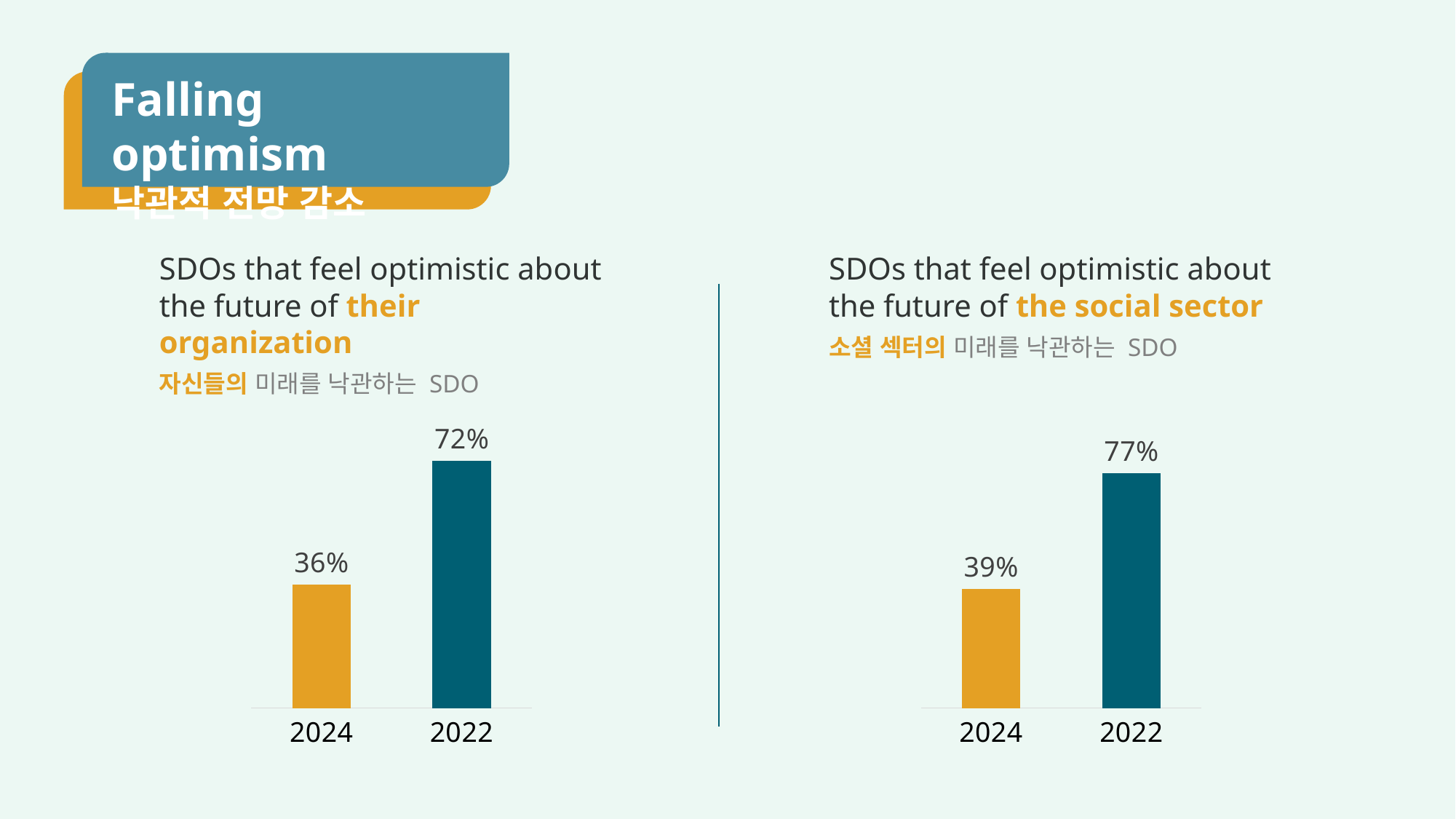
In the left chart (SDOs optimistic about the future of their organization), which year has the higher value? 2022 What colour is the 2024 bar in the left chart (SDOs optimistic about the future of their organization)? orange What type of chart is used on the left side of the slide? bar chart In the left chart (SDOs optimistic about the future of their organization), what is the difference between the 2022 and 2024 values? 36% In the left chart (SDOs optimistic about the future of their organization), what is the value for 2024? 36% In the right chart (SDOs optimistic about the future of the social sector), what is the value for 2024? 39% In the right chart (SDOs optimistic about the future of the social sector), what is the value for 2022? 77% In the right chart (SDOs optimistic about the future of the social sector), which year has the lower value? 2024 In the left chart (SDOs optimistic about the future of their organization), what is the value for 2022? 72% In the right chart (SDOs optimistic about the future of the social sector), what is the difference between the 2022 and 2024 values? 38% Is the 2024 value in the left chart (their organization) larger or smaller than the 2024 value in the right chart (the social sector)? smaller How many bars are shown in the right chart (SDOs optimistic about the future of the social sector)? 2